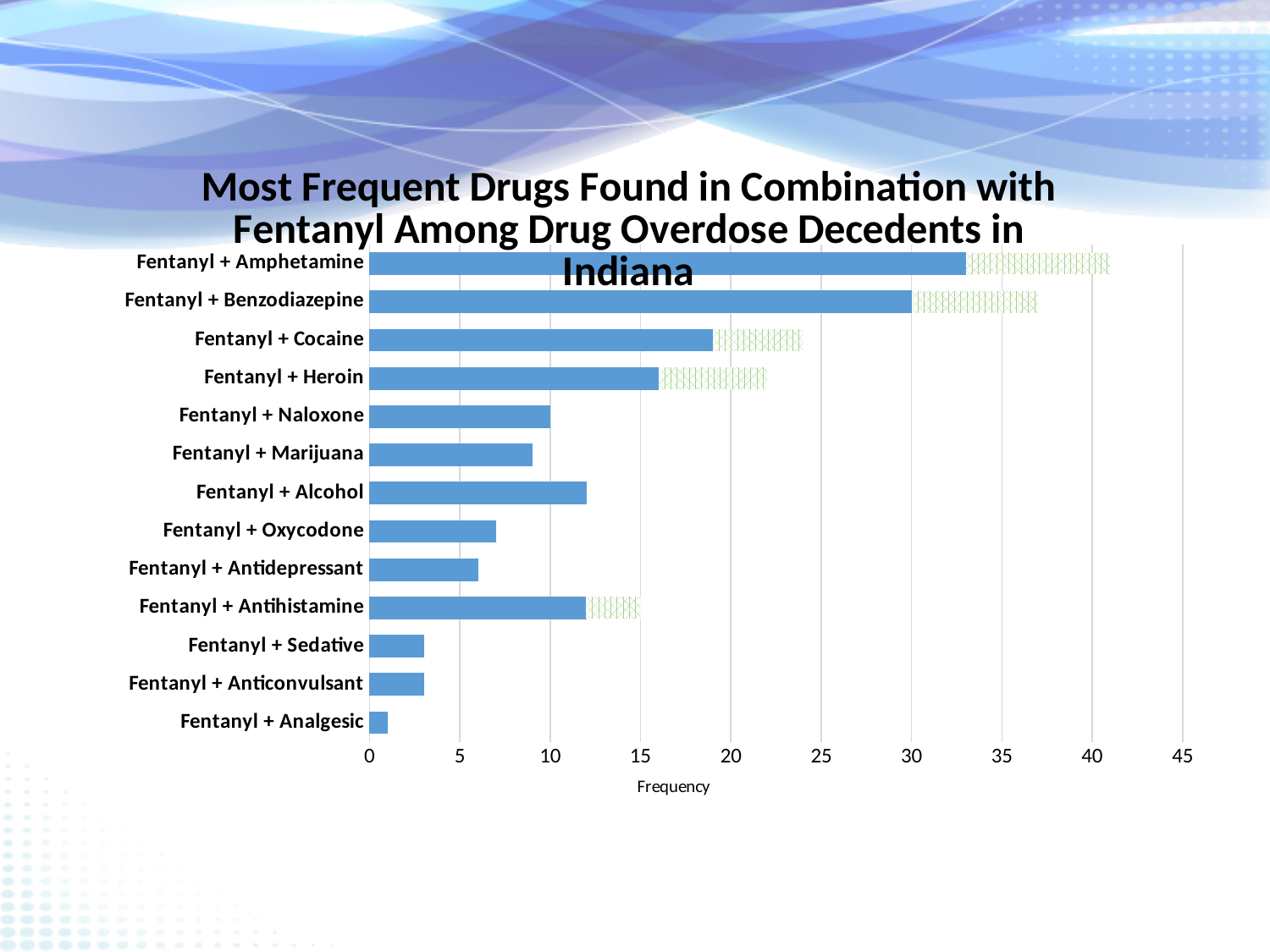
Which has a higher frequency, Fentanyl + Cocaine or Fentanyl + Heroin? Fentanyl + Cocaine Is the value for Fentanyl + Oxycodone greater or less than 10? less What kind of chart is shown on the slide? bar chart Is the value for Fentanyl + Alcohol greater or less than 10? greater Which drug combination has the highest frequency? Fentanyl + Amphetamine What is the label on the horizontal axis of the chart? Frequency How many drug combination categories are plotted on the chart? 13 Which has a higher frequency, Fentanyl + Alcohol or Fentanyl + Marijuana? Fentanyl + Alcohol Is the value for Fentanyl + Sedative greater or less than 5? less Which drug combination has the lowest frequency? Fentanyl + Analgesic